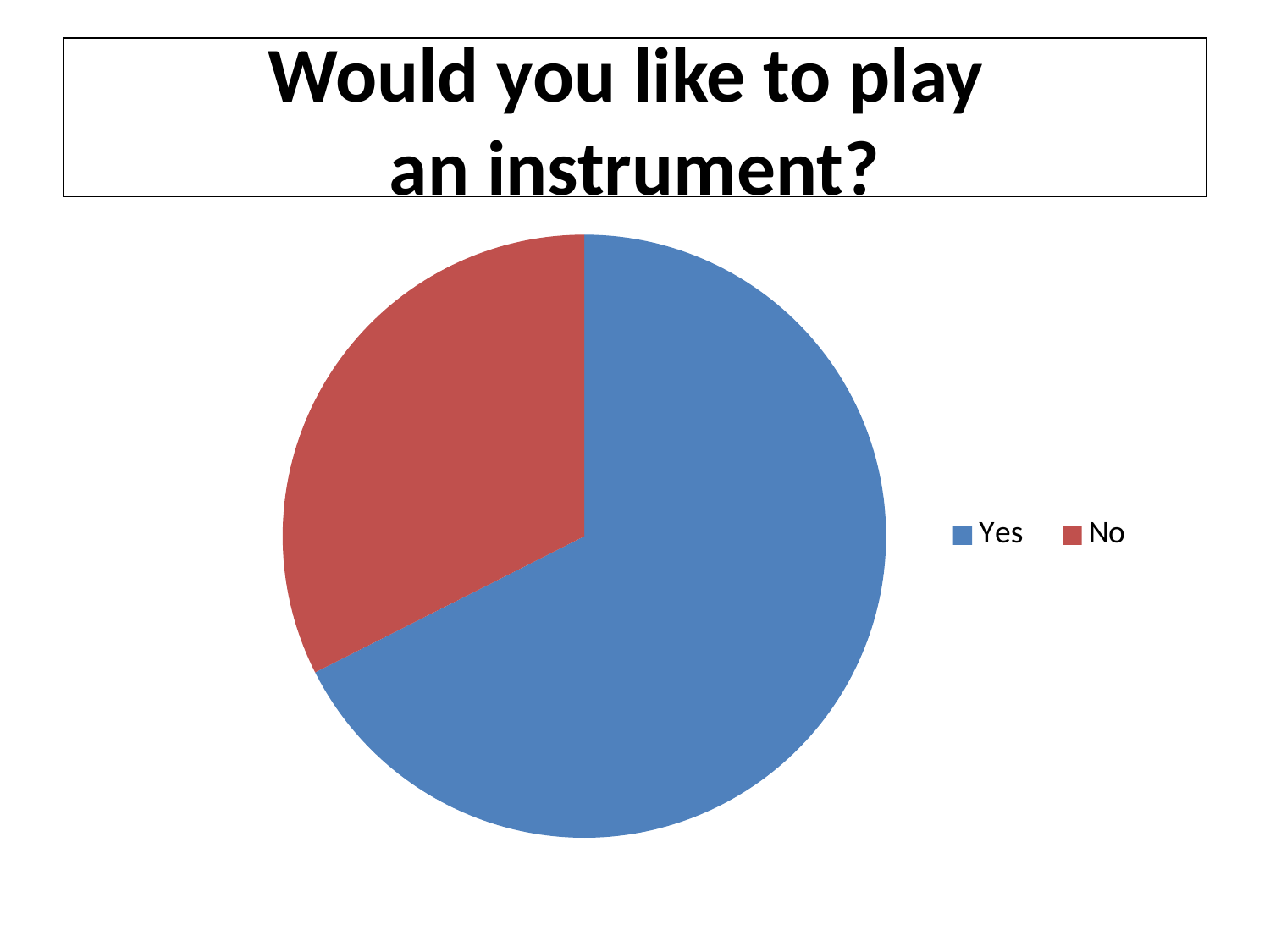
How many entries does the legend list? 2 Does the Yes slice take up more or less than half of the pie? more What is the title of the slide above the chart? Would you like to play an instrument? Which category has the smallest slice of the pie? No What colour is the Yes slice? blue Which slice is larger, Yes or No? Yes Which category has the largest slice of the pie? Yes How many categories does the pie chart show? 2 Does the No slice take up more or less than half of the pie? less What kind of chart is shown on the slide? pie chart